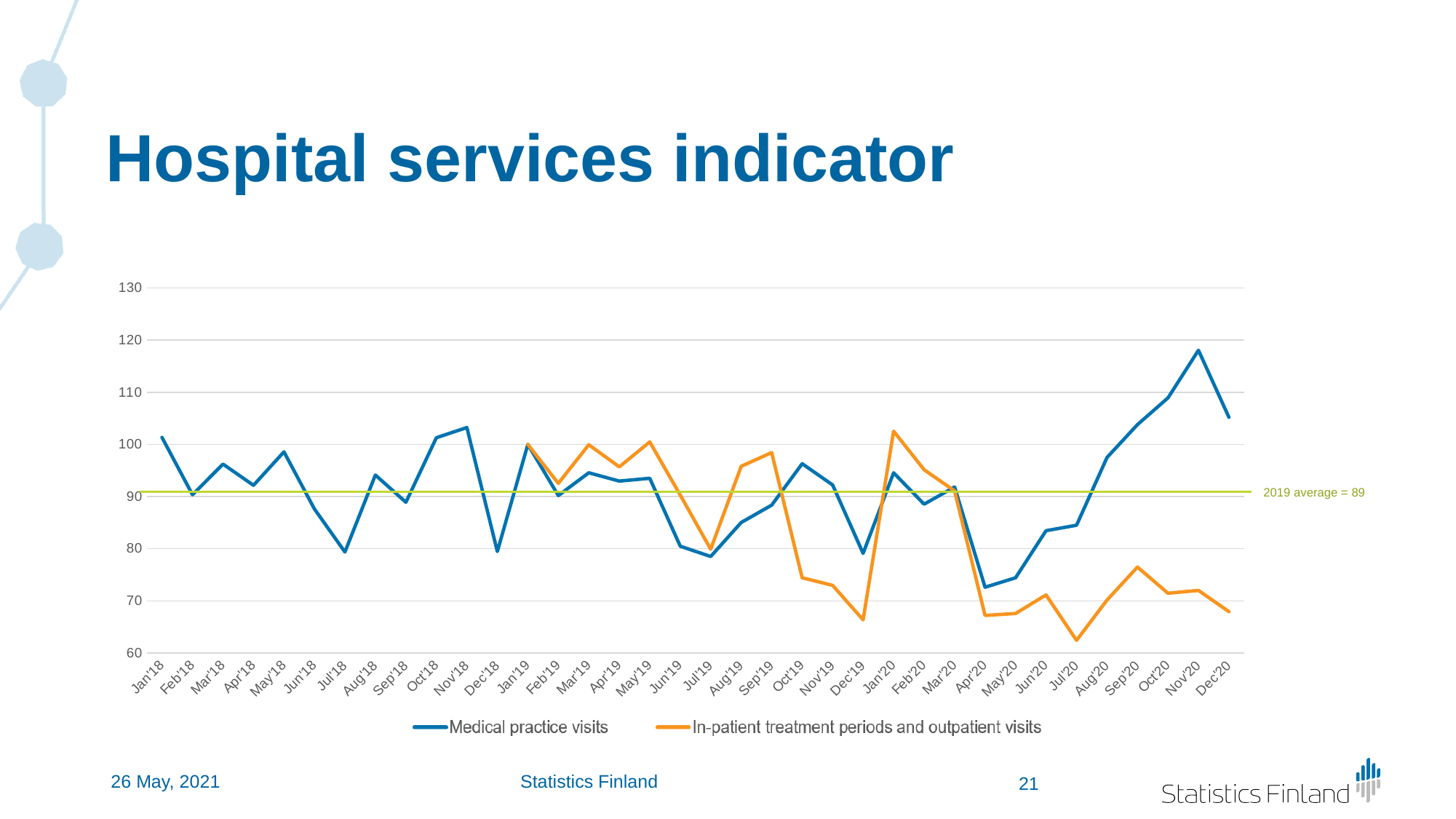
Is the value for Medical practice visits in Nov'20 greater or less than 110? greater In which month does the In-patient treatment periods and outpatient visits series reach its lowest value? Jul'20 Does the Medical practice visits series rise or fall from Jul'20 to Nov'20? rise How many months are shown on the x axis? 36 Is the value for In-patient treatment periods and outpatient visits in Oct'19 greater or less than 80? less In Dec'20, which series has the larger value: Medical practice visits or In-patient treatment periods and outpatient visits? Medical practice visits In which month does the Medical practice visits series reach its lowest value? Apr'20 Is the value for In-patient treatment periods and outpatient visits in Jul'20 greater or less than 70? less How many series does the legend list? 2 In which month does the Medical practice visits series reach its highest value? Nov'20 What kind of chart is shown on the slide? line chart What value does the horizontal reference line on the chart represent, according to its label? 2019 average = 89